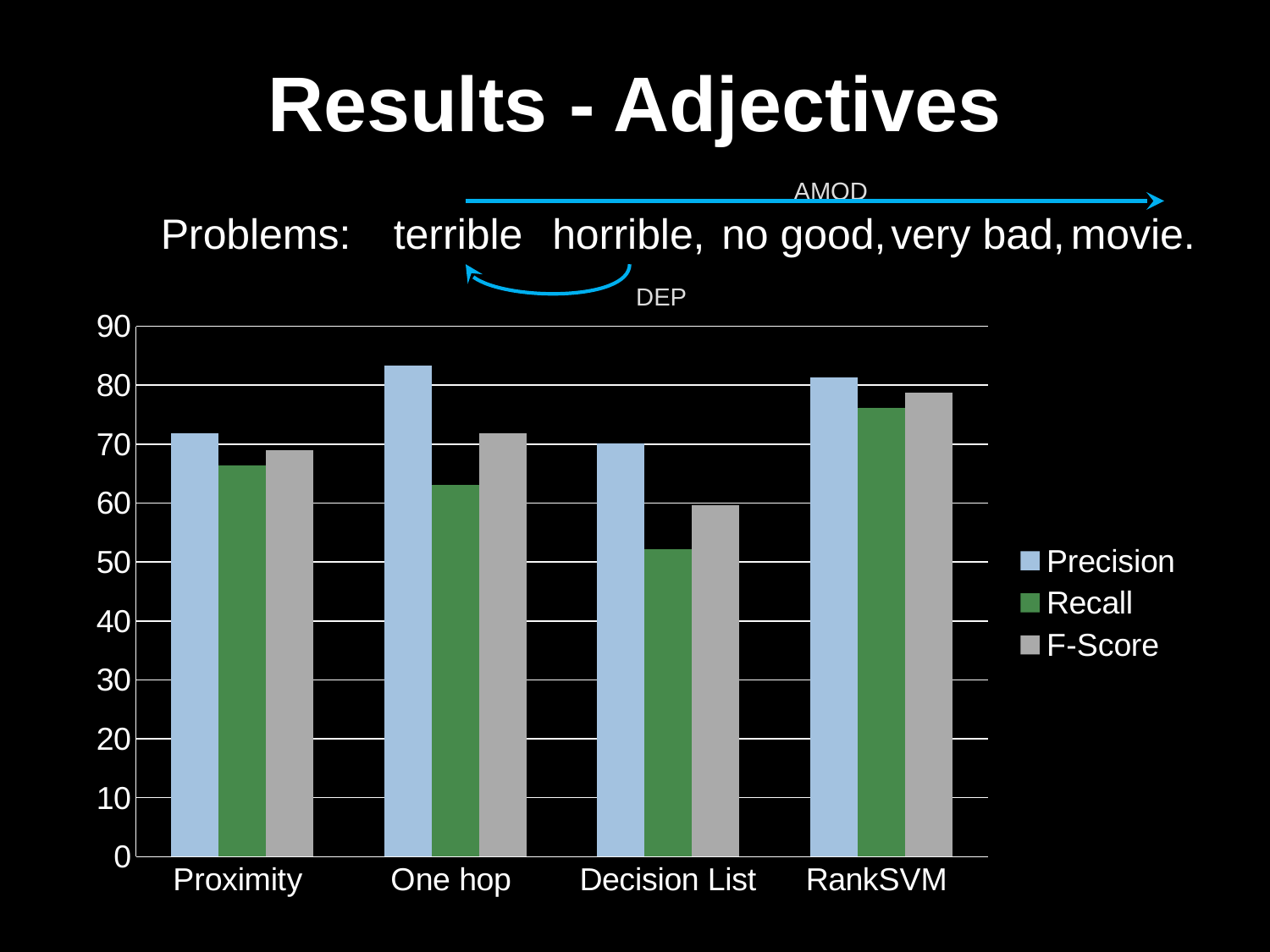
Is the Recall value for Decision List greater or less than 60? less What kind of chart is shown on the slide? bar chart Which category has the lowest F-Score? Decision List How many series does the legend list? 3 Which category has the highest F-Score? RankSVM Which category has the lowest Recall? Decision List Which is larger for One hop: Precision or Recall? Precision Is the Recall value for One hop greater or less than 70? less Is the Precision value for One hop greater or less than 80? greater Which series is shown in green in the legend? Recall How many categories are shown on the x axis? 4 Which category has the highest Recall? RankSVM